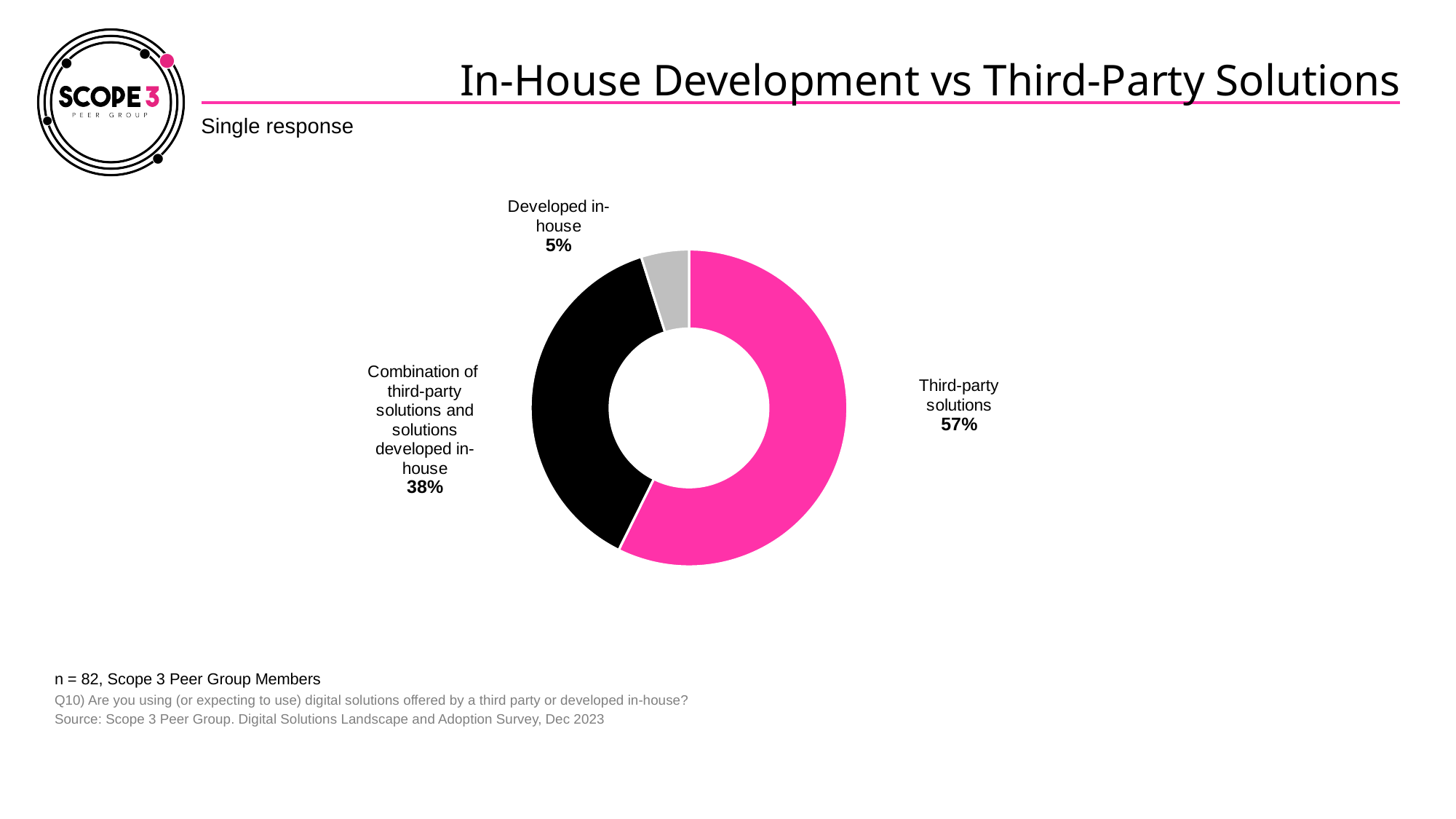
What percentage of respondents use a combination of third-party solutions and solutions developed in-house? 38% What is the difference in percentage points between third-party solutions and the combination category? 19 What is the difference in percentage points between the combination category and developed in-house? 33 What colour is the slice for third-party solutions? Pink What kind of chart is shown on the slide? Doughnut (pie) chart What percentage of respondents use third-party solutions? 57% How many categories are shown in the chart? 3 Which category has the smallest share of the chart? Developed in-house Which is larger: the share for third-party solutions or the share for the combination of third-party and in-house solutions? Third-party solutions Which category has the largest share of the chart? Third-party solutions What is the title of the slide? In-House Development vs Third-Party Solutions What percentage of respondents use solutions developed in-house? 5%